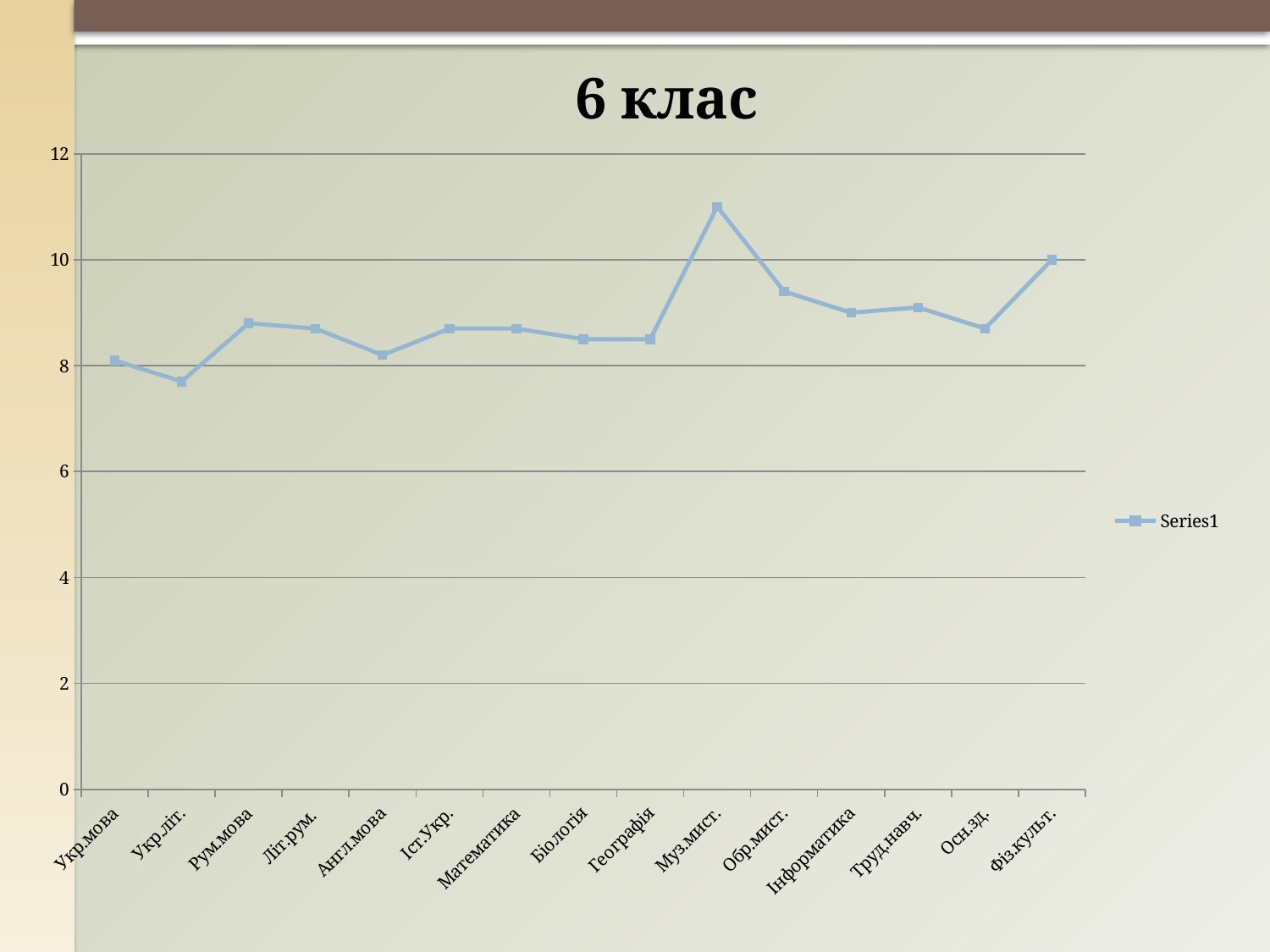
What is the title of the chart? 6 клас Is the value for Обр.мист. greater or less than 8? greater Is the value for Укр.літ. greater or less than 8? less Which category has the highest value? Муз.мист. Which is larger, the value for Укр.літ. or the value for Обр.мист.? Обр.мист. What type of chart is shown on the slide? line chart Which is larger, the value for Муз.мист. or the value for Фіз.культ.? Муз.мист. Is the value for Муз.мист. greater or less than 10? greater How many series does the legend list? 1 Which category has the lowest value? Укр.літ. How many categories are plotted along the x axis? 15 What is the value for Фіз.культ.? 10